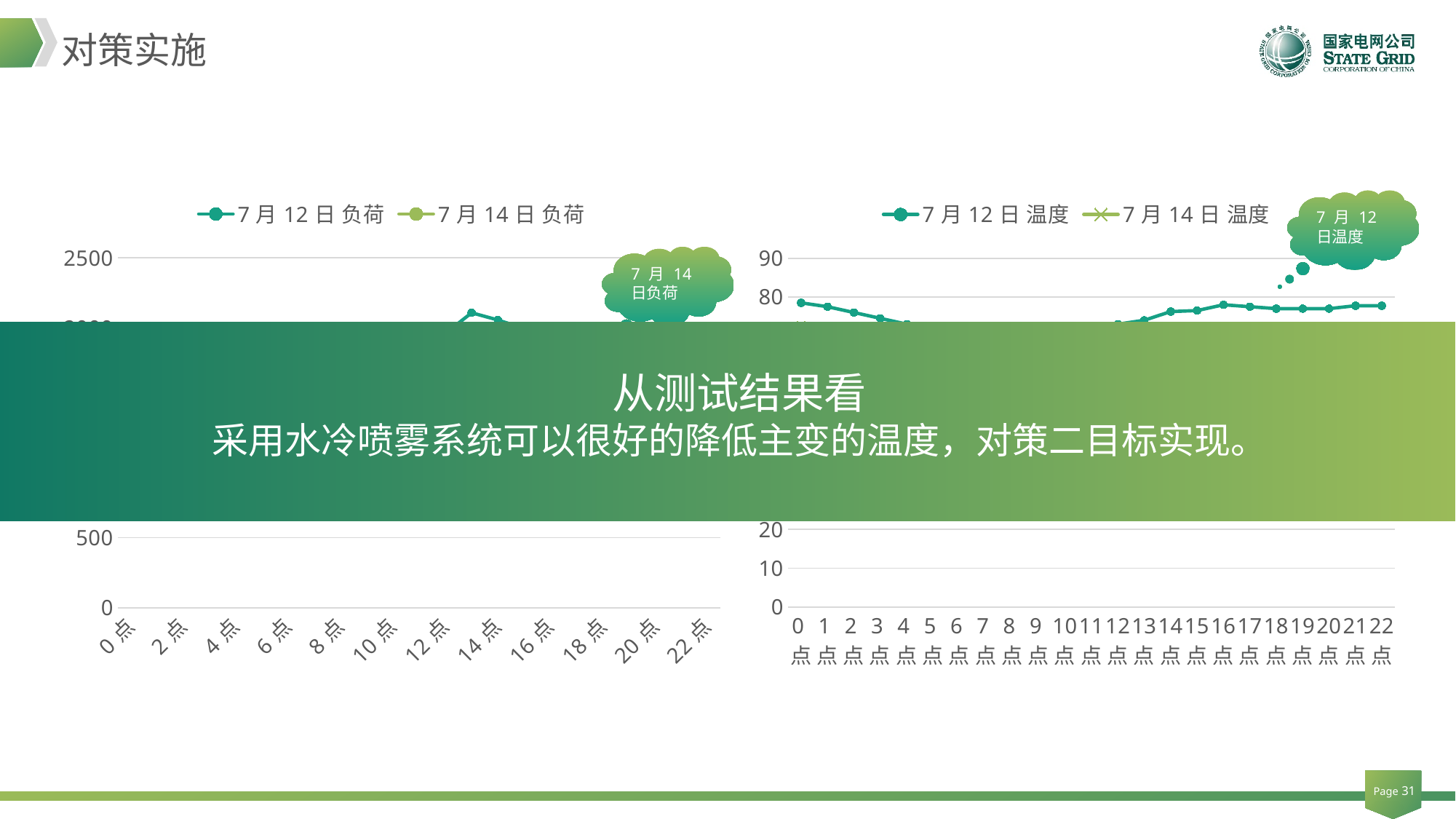
In the left chart (负荷), is the value for 7月12日负荷 at 14点 greater or less than 2500? less How many series does the legend of the left chart (负荷) list? 2 How many x-axis categories does the right chart (温度) show? 23 In the right chart (温度), is the value for 7月12日温度 at 0点 greater or less than 90? less How many series does the legend of the right chart (温度) list? 2 In the right chart (温度), does the 7月12日温度 line rise or fall from 0点 to 4点? fall In the left chart (负荷), is the value for 7月12日负荷 at 14点 greater or less than 500? greater What are the two legend entries of the right chart (温度)? 7月12日温度, 7月14日温度 What kind of chart is the left chart (负荷)? line chart What is the highest y-axis tick value shown on the left chart (负荷)? 2500 What kind of chart is the right chart (温度)? line chart